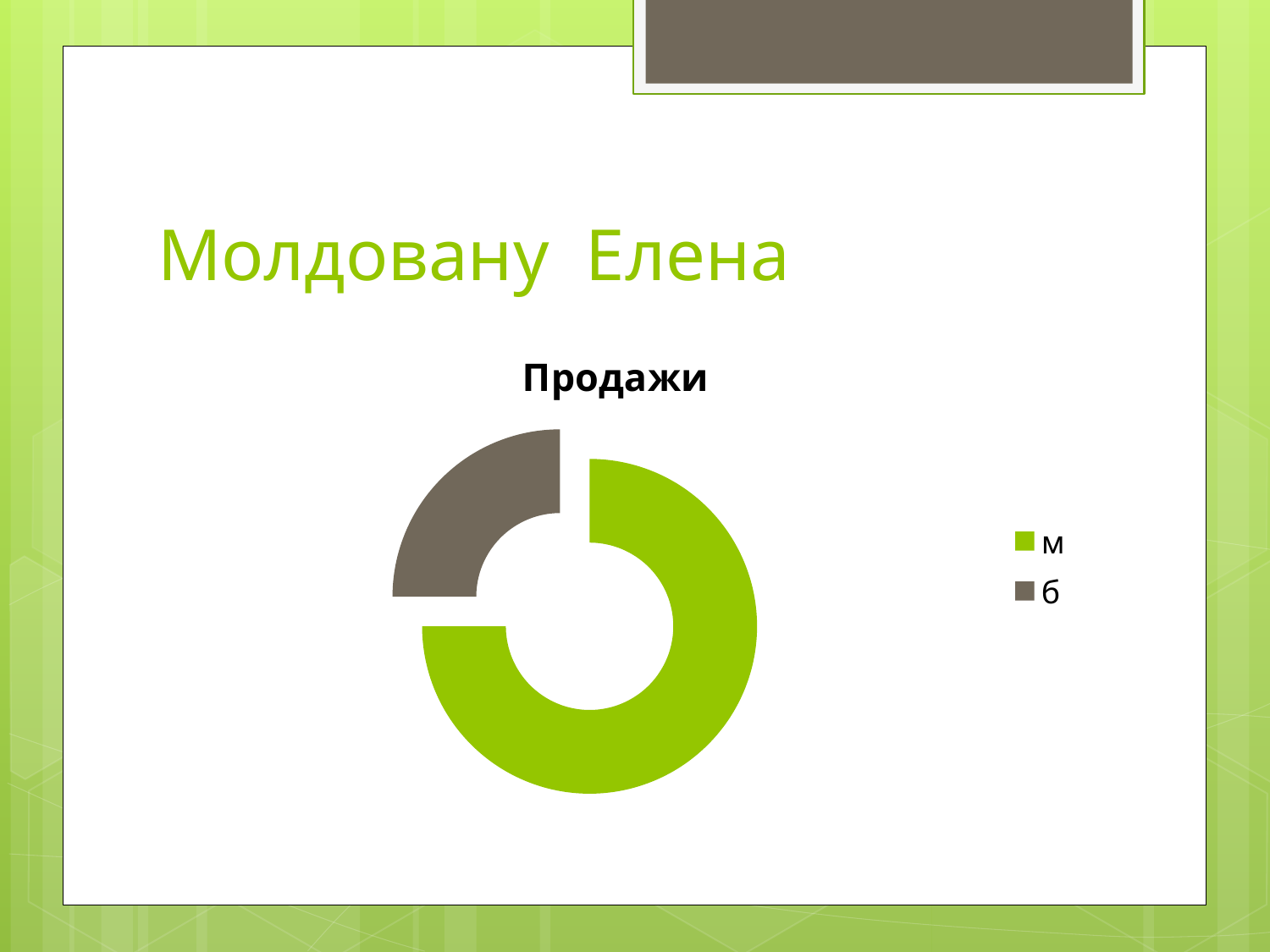
What colour represents the category б in the chart? brown How many categories does the chart show? 2 Which category is shown in green? м What kind of chart is shown on the slide? doughnut chart Which is larger, the share for м or the share for б? м Which category has the smallest share of the chart? б What is the title of the chart? Продажи Which category has the largest share of the chart? м